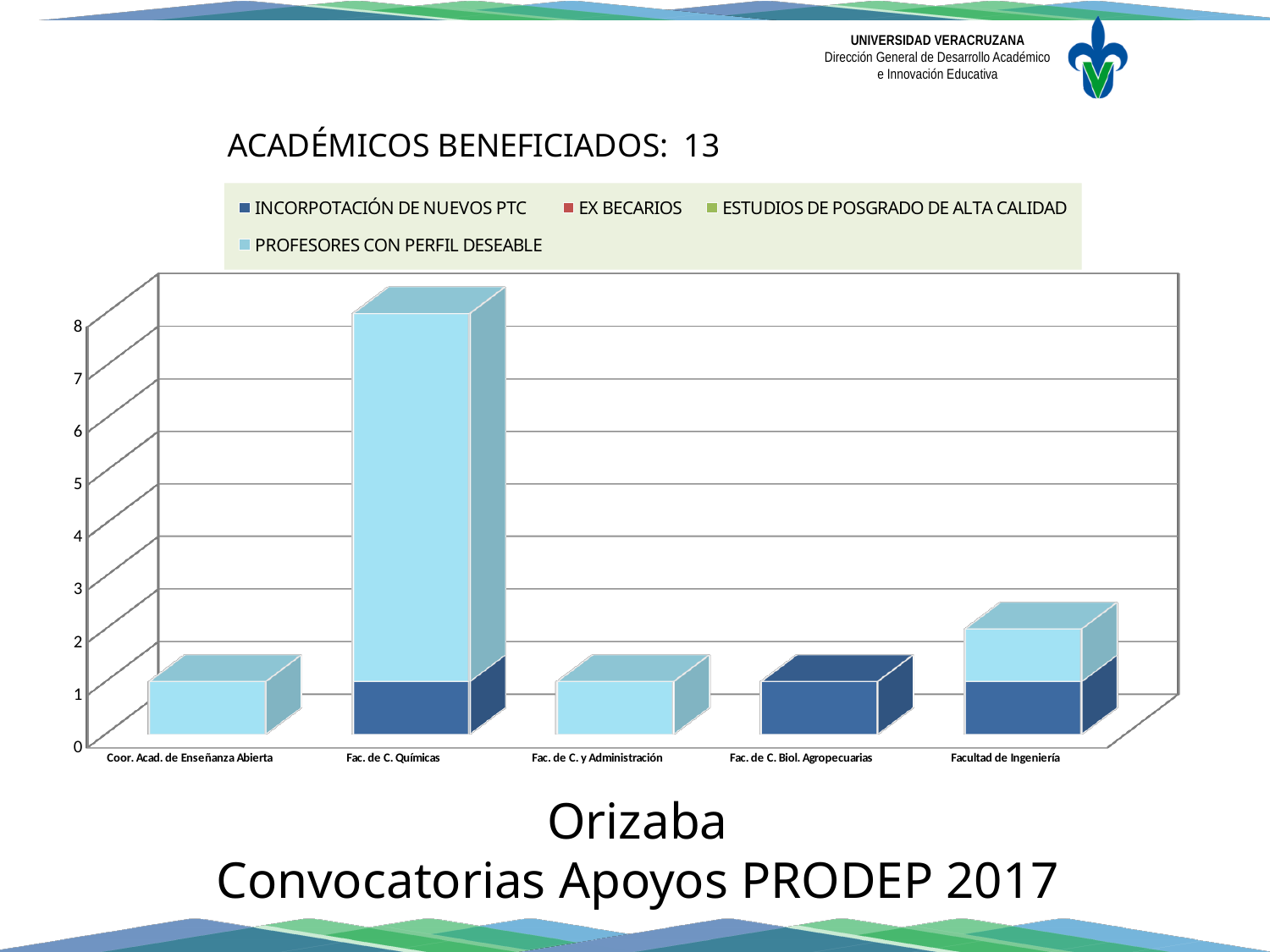
Which legend series is shown in dark blue? INCORPOTACIÓN DE NUEVOS PTC What kind of chart is shown on the slide? bar chart Is the stacked bar for Coor. Acad. de Enseñanza Abierta greater or less than 3? less Which has the taller stacked bar, Fac. de C. Químicas or Facultad de Ingeniería? Fac. de C. Químicas How many categories are shown along the x axis of the chart? 5 What is the total of the stacked bar for Fac. de C. Químicas? 8 Is the total stacked value for Fac. de C. Químicas greater or less than 5? greater How many series does the chart legend list? 4 What is the total of the stacked bar for Facultad de Ingeniería? 2 According to the heading above the chart, how many ACADÉMICOS BENEFICIADOS are there? 13 Which category has the tallest stacked bar? Fac. de C. Químicas Is the total stacked value for Facultad de Ingeniería greater or less than 4? less